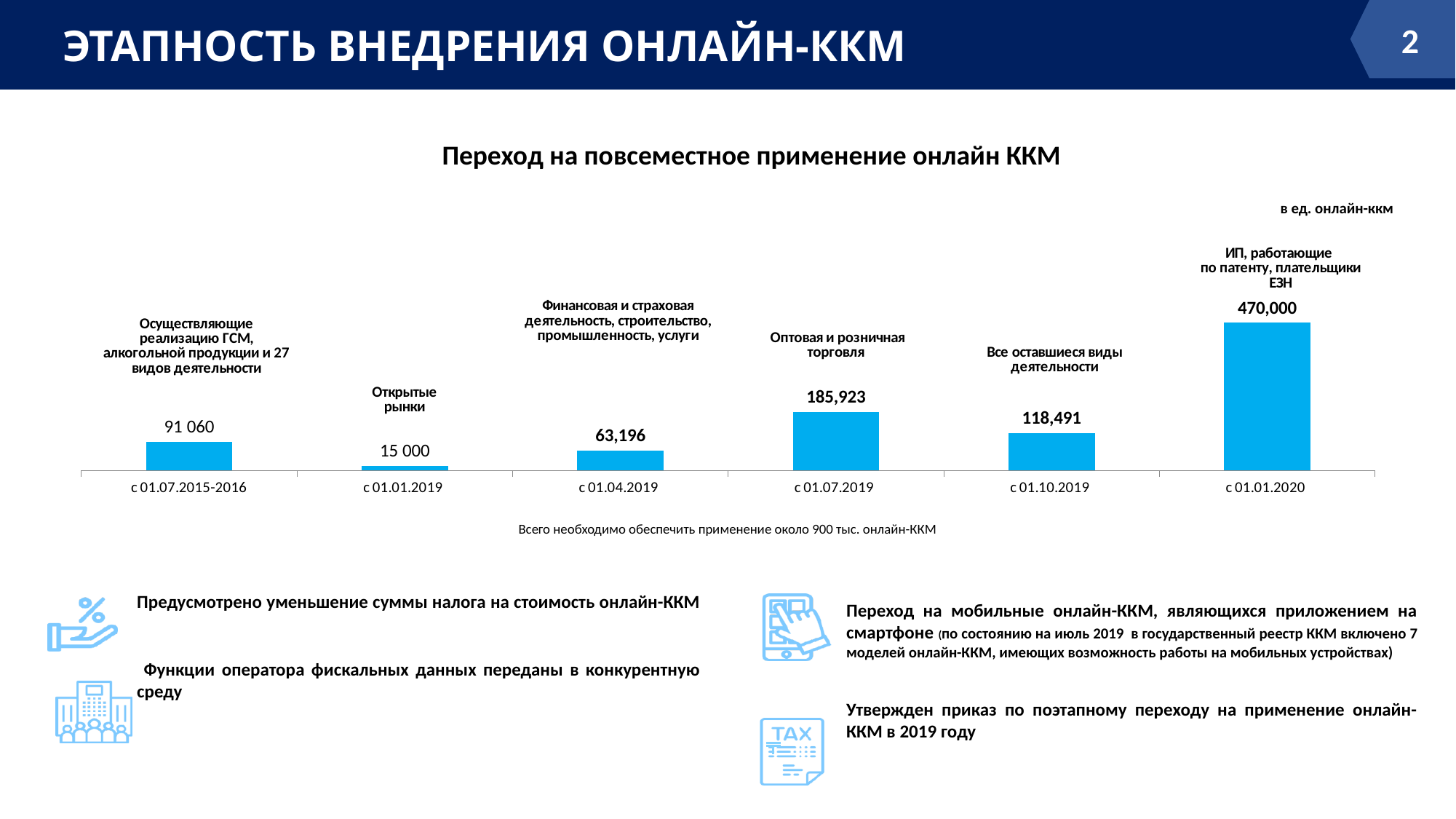
How many bars (categories) does the chart contain? 6 What type of chart is shown on the slide? bar chart What is the value for the bar labelled "с 01.01.2019" (Открытые рынки)? 15 000 Which category has the highest value? с 01.01.2020 What is the title of the chart? Переход на повсеместное применение онлайн ККМ What is the difference between the values for "с 01.07.2019" and "с 01.10.2019"? 67,432 What is the value for the bar labelled "с 01.01.2020"? 470,000 What is the difference between the values for "с 01.01.2020" and "с 01.07.2019"? 284,077 Which is larger: the value for "с 01.07.2015-2016" or the value for "с 01.04.2019"? с 01.07.2015-2016 What is the value for the bar labelled "с 01.04.2019"? 63,196 What is the value for the bar labelled "с 01.07.2019" (Оптовая и розничная торговля)? 185,923 Which category has the lowest value? с 01.01.2019